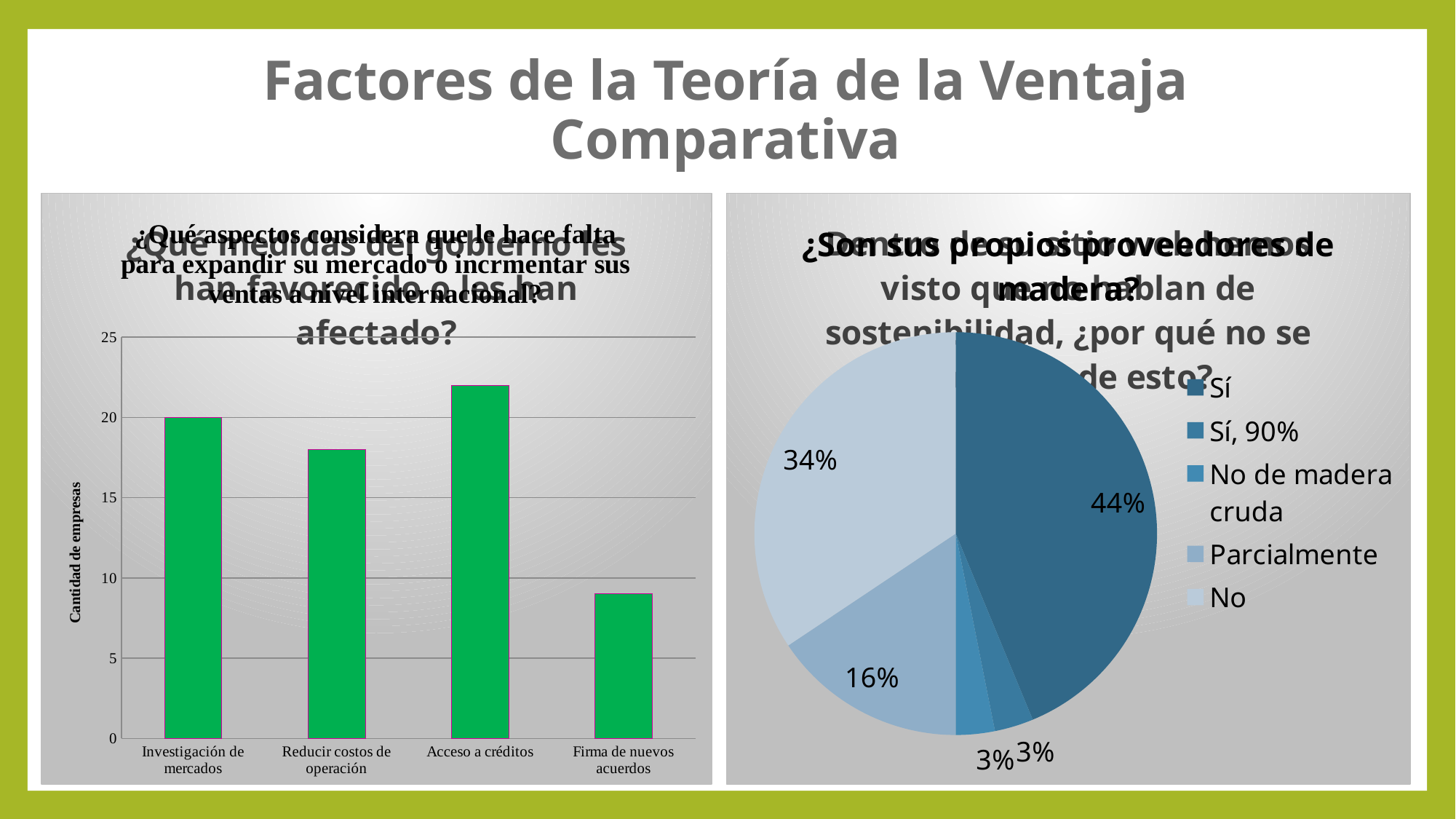
In the bar chart on the left, what is the value for Investigación de mercados? 20 In the pie chart on the right, what share does the No slice have? 34% In the bar chart on the left, is the value for Acceso a créditos greater or less than 20? greater In the pie chart on the right, what share does the Sí slice have? 44% What kind of chart is the chart on the right of the slide? pie chart What kind of chart is the chart on the left of the slide? bar chart In the bar chart on the left, which is larger: Investigación de mercados or Reducir costos de operación? Investigación de mercados How many entries does the legend of the pie chart on the right list? 5 In the bar chart on the left, is the value for Firma de nuevos acuerdos greater or less than 10? less In the bar chart on the left, which category has the lowest value? Firma de nuevos acuerdos In the bar chart on the left, which category has the highest value? Acceso a créditos How many categories are shown in the bar chart on the left? 4